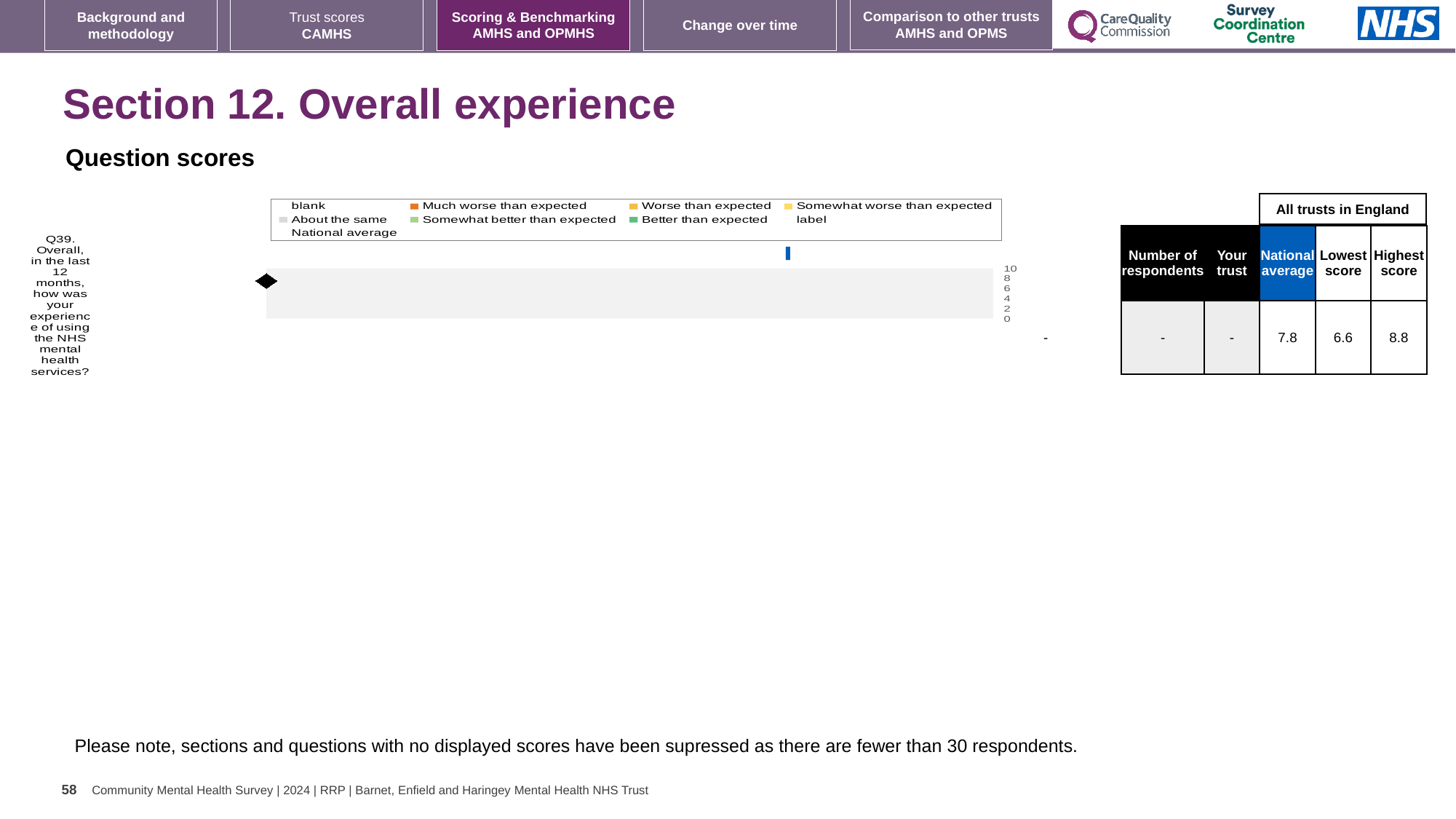
What is the national average score for Q39 shown in the table? 7.8 What is the highest score across all trusts in England for Q39? 8.8 What is the lowest score across all trusts in England for Q39? 6.6 What value is shown for 'Your trust' for Q39? - What is the difference between the highest score and the lowest score for Q39? 2.2 How many questions are plotted on the chart? 1 What is the difference between the national average and the lowest score for Q39? 1.2 Is the national average for Q39 greater or less than 5? greater What is the heading above the National average, Lowest score and Highest score columns? All trusts in England What is the highest tick value shown on the chart's score axis? 10 Is the national average for Q39 greater or less than the lowest score? greater What kind of chart is used for the Q39 question score? bar chart